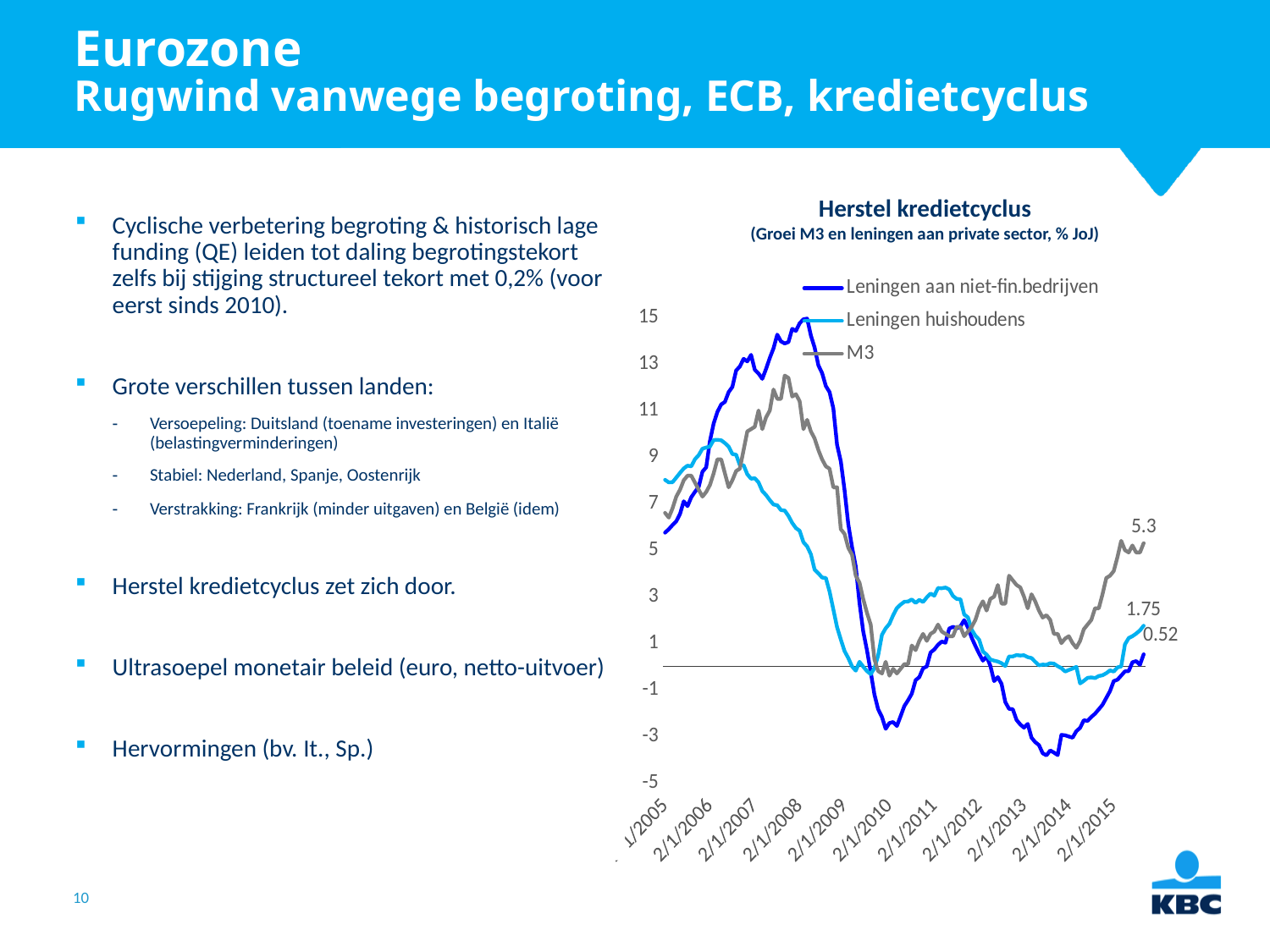
Is the lowest value of 'Leningen aan niet-fin.bedrijven' around 2014 greater or less than -3? less What is the final data label shown for the 'Leningen aan niet-fin.bedrijven' series? 0.52 What is the subtitle printed under the chart title 'Herstel kredietcyclus'? (Groei M3 en leningen aan private sector, % JoJ) What is the difference between the final data labels of M3 (5.3) and 'Leningen huishoudens' (1.75)? 3.55 Which series has the highest value at the right end of the chart? M3 What is the final data label shown for the 'Leningen huishoudens' series? 1.75 How many series does the legend of the 'Herstel kredietcyclus' chart list? 3 Is the peak value of 'Leningen aan niet-fin.bedrijven' around 2008 greater or less than 13? greater What is the final data label shown for the M3 series? 5.3 What kind of chart is shown under the title 'Herstel kredietcyclus'? line chart Does the 'Leningen aan niet-fin.bedrijven' series rise or fall between 2005 and 2008? rise Around 2008, which series reaches a higher peak: 'Leningen aan niet-fin.bedrijven' or 'Leningen huishoudens'? Leningen aan niet-fin.bedrijven